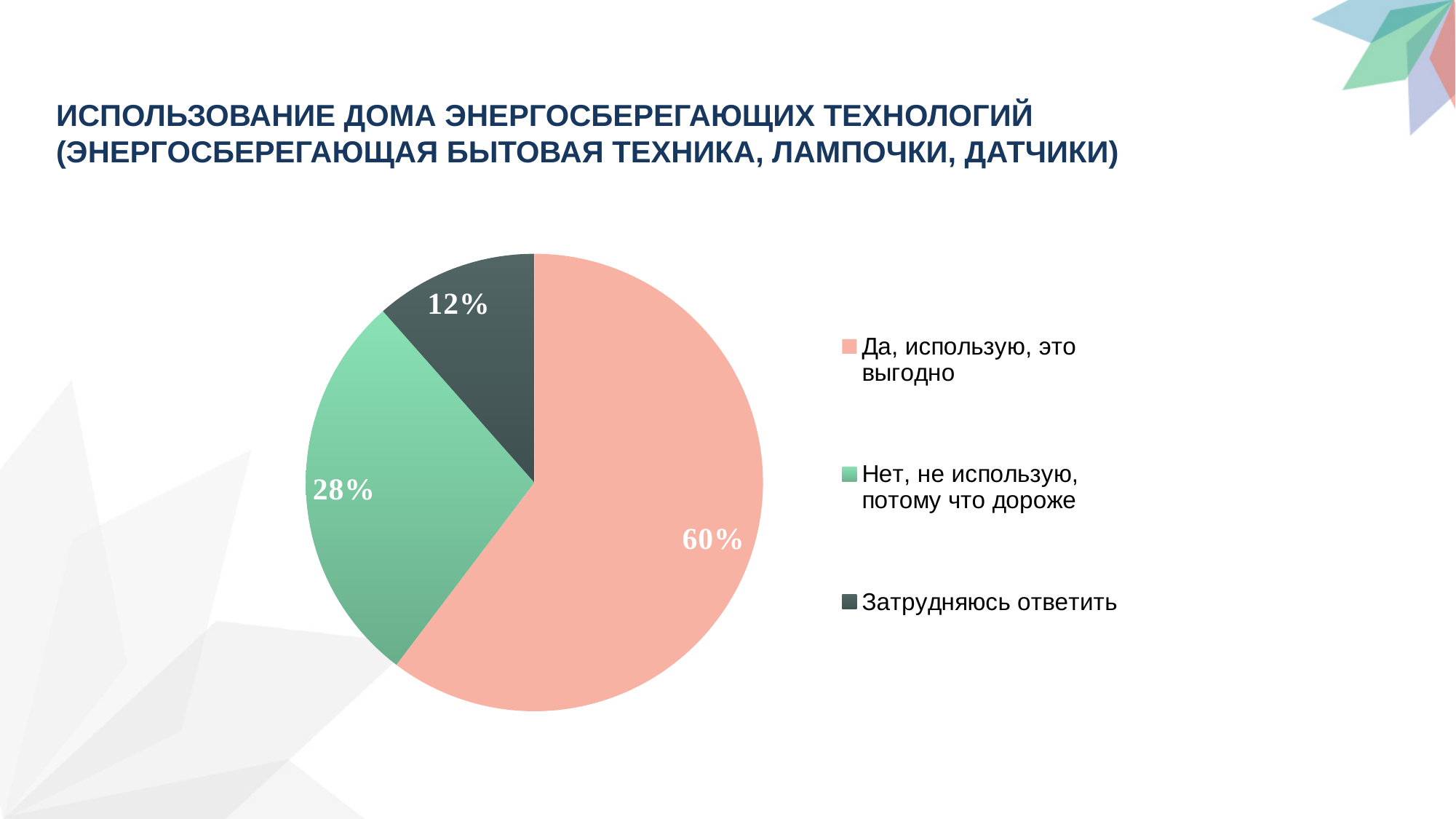
Which category has the largest slice of the pie? Да, использую, это выгодно What is the difference between the share for "Да, использую, это выгодно" and the share for "Нет, не использую, потому что дороже"? 32% What share of the pie is labelled "Затрудняюсь ответить"? 12% How many slices does the pie chart have? 3 What share of the pie is labelled "Да, использую, это выгодно"? 60% What kind of chart is shown on the slide? Pie chart What colour is the slice for "Затрудняюсь ответить"? Dark grey-green Which is larger: the share for "Нет, не использую, потому что дороже" or the share for "Затрудняюсь ответить"? Нет, не использую, потому что дороже How many entries does the legend list? 3 Which category has the smallest slice of the pie? Затрудняюсь ответить What is the difference between the share for "Нет, не использую, потому что дороже" and the share for "Затрудняюсь ответить"? 16% What share of the pie is labelled "Нет, не использую, потому что дороже"? 28%